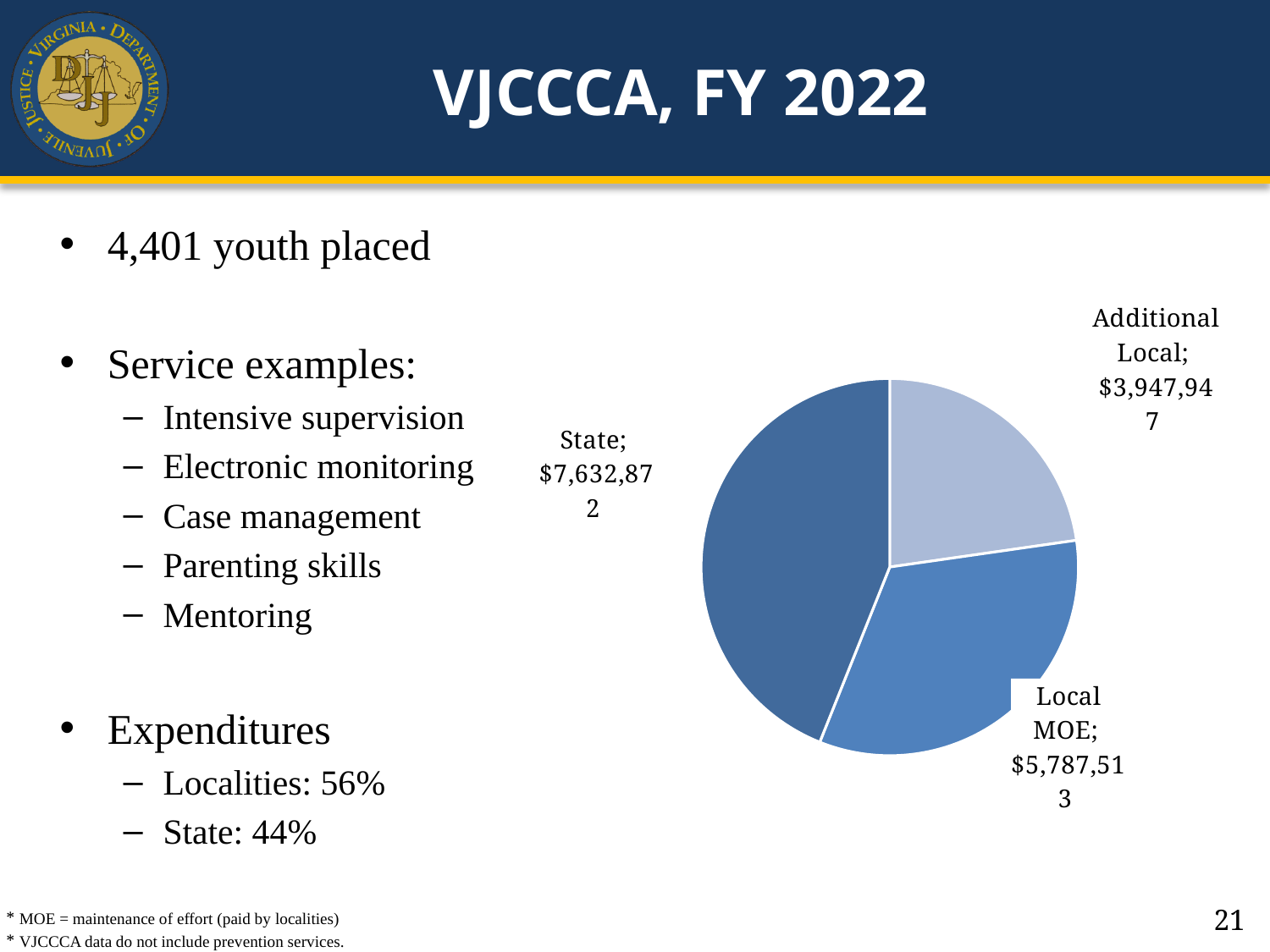
How many slices does the pie chart have? 3 What is the value of the Additional Local slice in the pie chart? $3,947,947 What is the difference between the State slice and the Local MOE slice? $1,845,359 What is the value of the Local MOE slice in the pie chart? $5,787,513 What is the total of all three slices in the pie chart? $17,368,332 Which slice of the pie chart is the largest? State What is the difference between the State slice and the Additional Local slice? $3,684,925 What is the value of the State slice in the pie chart? $7,632,872 Which is larger in the pie chart, Local MOE or Additional Local? Local MOE What share of the expenditures pie does the State slice represent? 44% Which slice of the pie chart is the smallest? Additional Local What type of chart is shown on the slide? pie chart